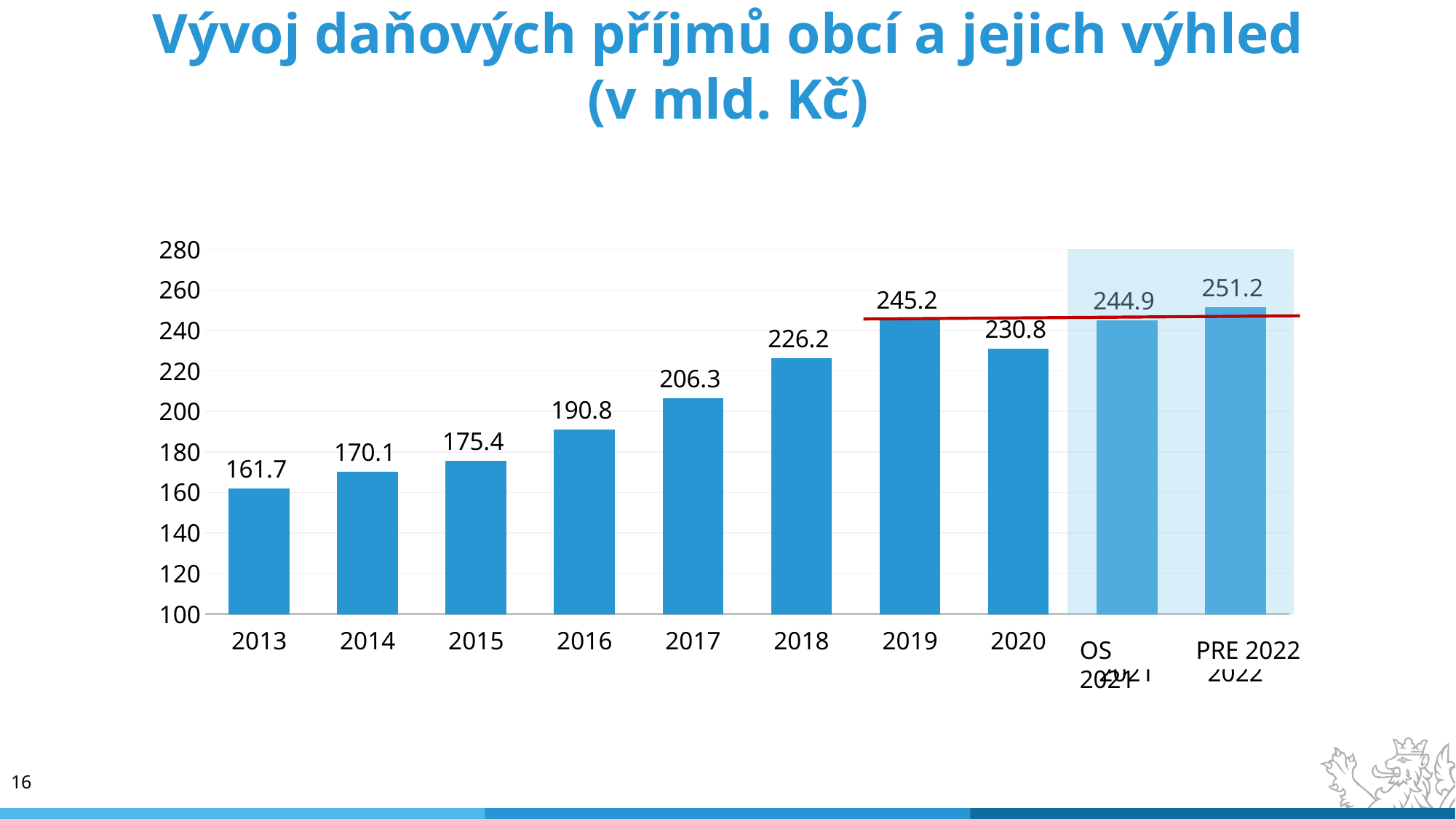
Which category has the highest value? PRE 2022 What is the value for PRE 2022? 251.2 What is the title of the slide? Vývoj daňových příjmů obcí a jejich výhled (v mld. Kč) How many bars are shown in the chart? 10 Which category has the lowest value? 2013 What is the value for 2013? 161.7 What is the difference between the values for 2019 and 2020? 14.4 Do the values rise or fall from 2013 to 2019? rise What kind of chart is shown on the slide? bar chart Which is larger, the value for 2019 or the value for OS 2021? 2019 What is the value for 2018? 226.2 Is the value for 2017 greater or less than 200? greater